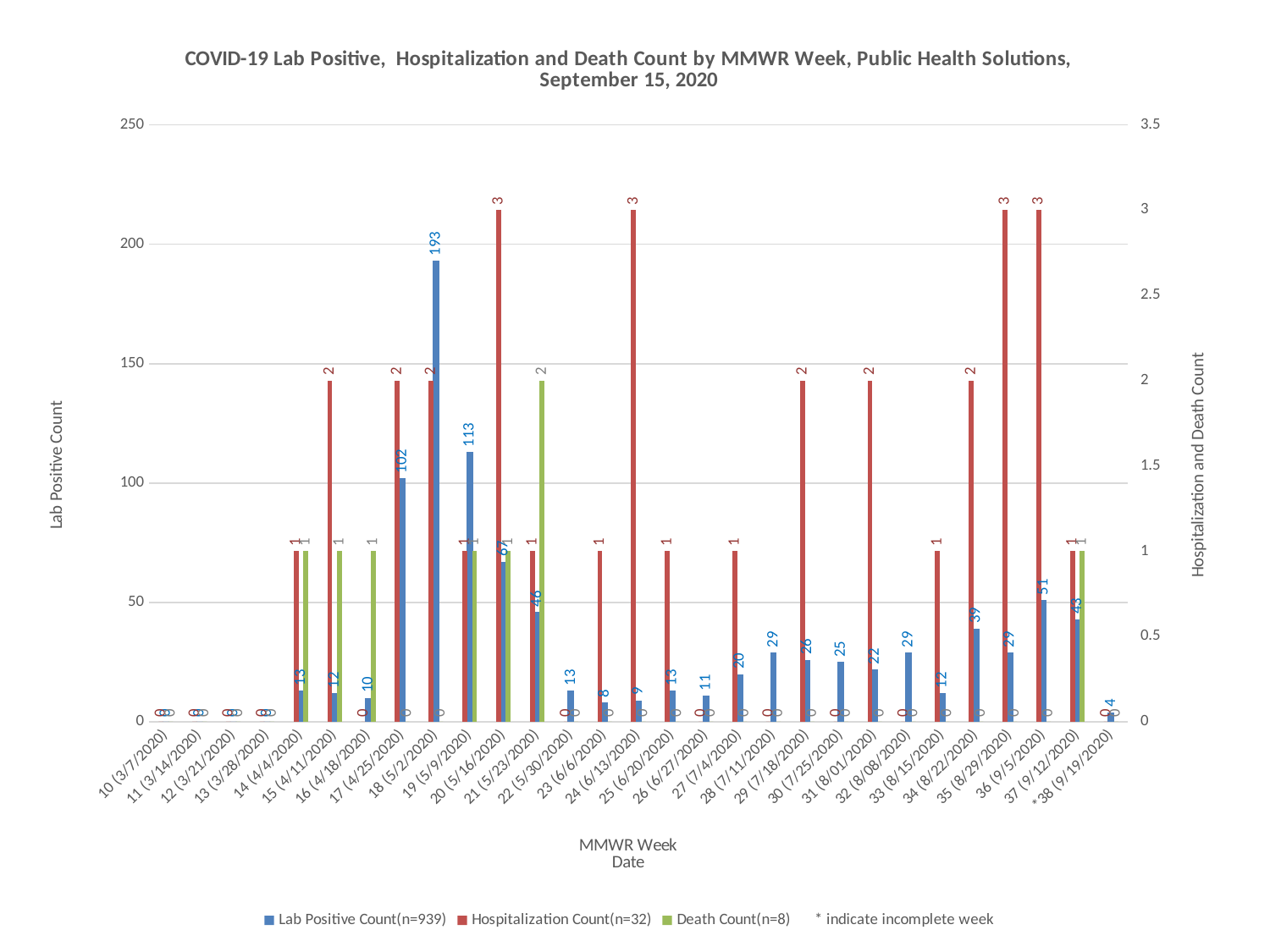
What is the Hospitalization Count for week 20 (5/16/2020)? 3 What is the Death Count for week 21 (5/23/2020)? 2 What is the title of the right-hand vertical axis? Hospitalization and Death Count What is the Lab Positive Count for week 17 (4/25/2020)? 102 Which MMWR week has the highest Lab Positive Count? 18 (5/2/2020) Which has the larger Lab Positive Count, week 36 (9/5/2020) or week 37 (9/12/2020)? 36 (9/5/2020) How many MMWR weeks are shown on the x axis? 29 What kind of chart is shown on the slide? bar chart What is the Lab Positive Count for week 18 (5/2/2020)? 193 How many series does the legend list? 3 What is the Lab Positive Count for week 19 (5/9/2020)? 113 What is the difference between the Lab Positive Count for week 18 (5/2/2020) and week 19 (5/9/2020)? 80